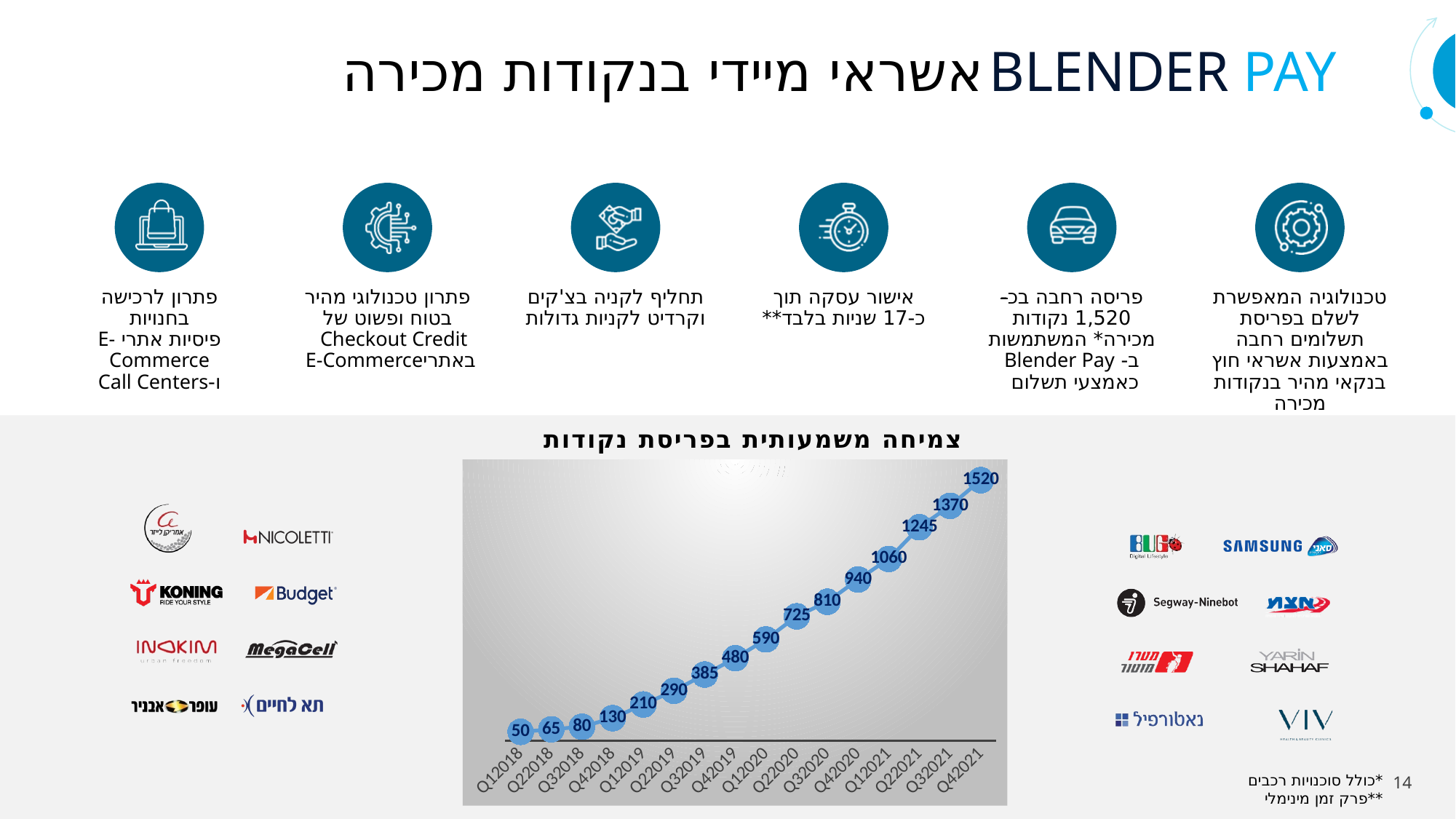
Which quarter has the lowest value? Q12018 What is the value for Q12018? 50 What is the value for Q42021? 1520 Do the values rise or fall from Q12018 to Q42021? rise What is the value for Q22020? 725 What is the difference between the values for Q42021 and Q32021? 150 Which is larger, the value for Q12020 or the value for Q42019? Q12020 What is the value for Q32019? 385 What is the difference between the values for Q42018 and Q12019? 80 What kind of chart is shown on the slide? line chart Which quarter has the highest value? Q42021 How many quarters are plotted on the x axis? 16